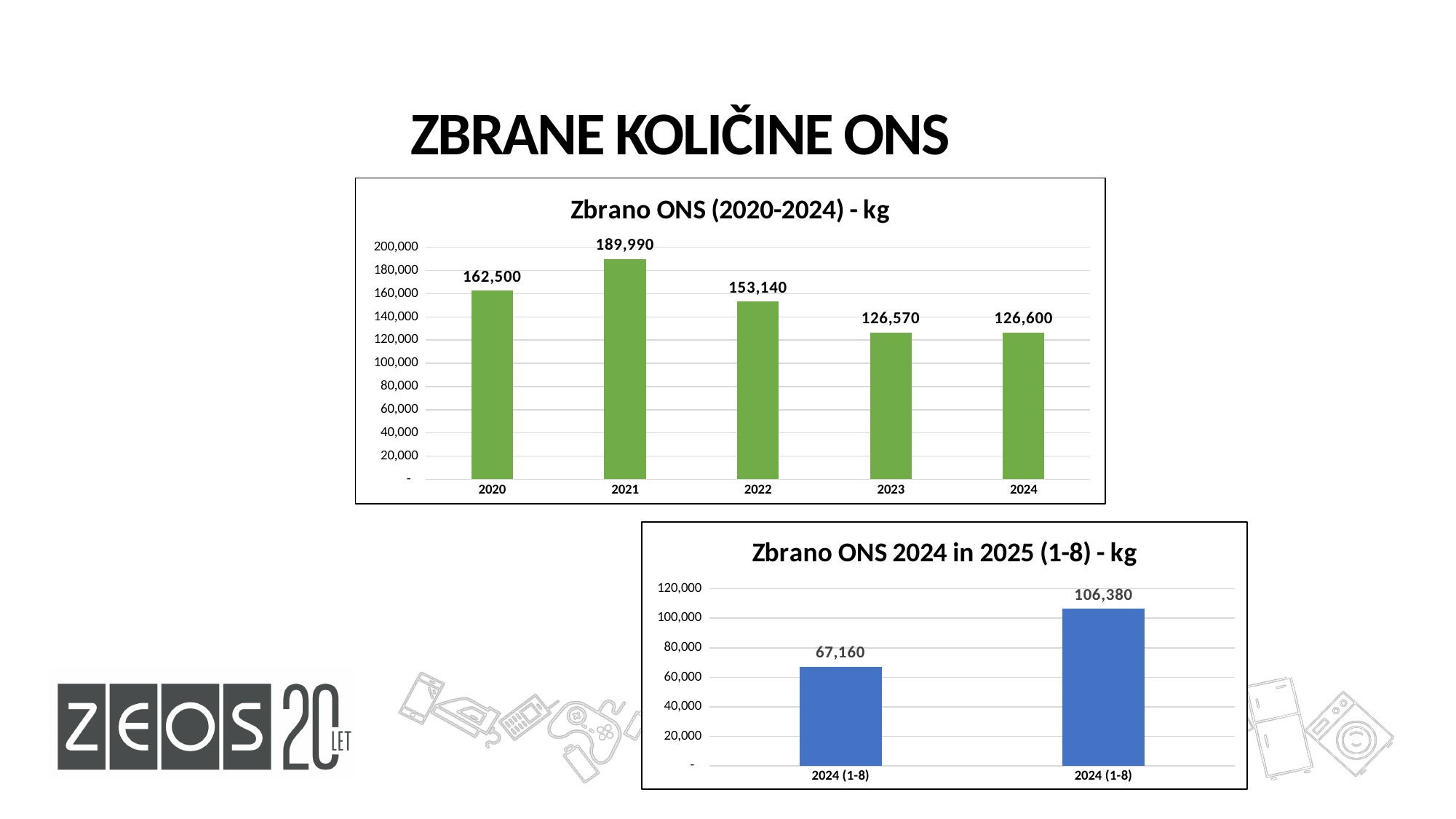
What colour are the bars in the chart titled "Zbrano ONS (2020-2024) - kg"? green In the chart titled "Zbrano ONS (2020-2024) - kg", how many years are shown? 5 In the chart titled "Zbrano ONS (2020-2024) - kg", what is the difference between the values for 2021 and 2020? 27,490 In the chart titled "Zbrano ONS (2020-2024) - kg", what is the value for 2023? 126,570 In the chart titled "Zbrano ONS 2024 in 2025 (1-8) - kg", what is the difference between the right-hand bar and the left-hand bar? 39,220 In the chart titled "Zbrano ONS (2020-2024) - kg", which year has the highest value? 2021 In the chart titled "Zbrano ONS (2020-2024) - kg", is the value for 2022 greater or less than 140,000? greater In the chart titled "Zbrano ONS 2024 in 2025 (1-8) - kg", what is the value of the right-hand bar? 106,380 In the chart titled "Zbrano ONS (2020-2024) - kg", which is larger, the value for 2020 or the value for 2022? 2020 In the chart titled "Zbrano ONS (2020-2024) - kg", what is the value for 2021? 189,990 In the chart titled "Zbrano ONS (2020-2024) - kg", do the values rise or fall from 2021 to 2023? fall What kind of chart is the chart titled "Zbrano ONS 2024 in 2025 (1-8) - kg"? bar chart